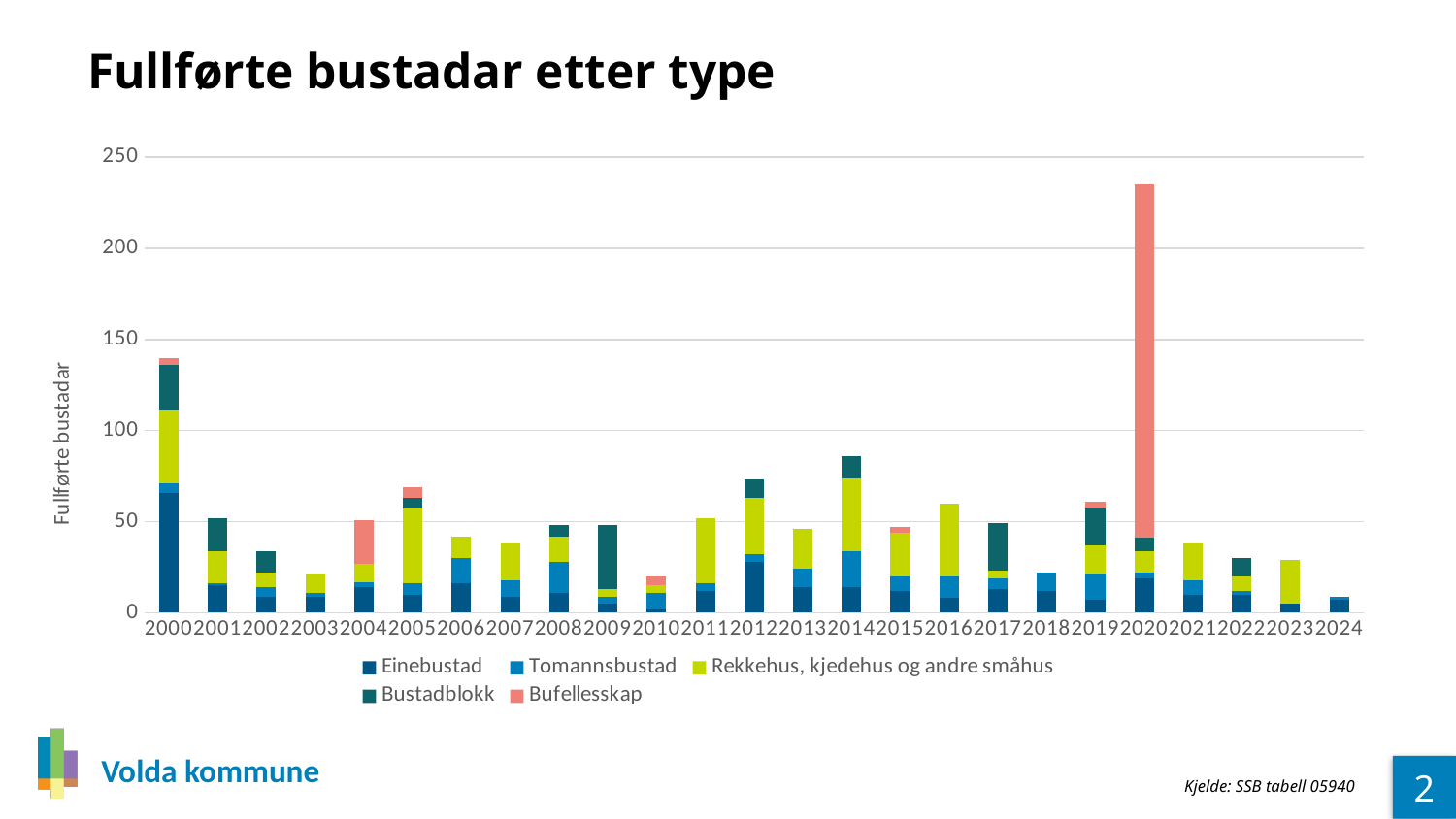
Which year has the lowest total of completed dwellings? 2024 Is the total for 2020 greater or less than 200? greater Is the total for 2014 greater or less than 50? greater Which year has a larger total, 2000 or 2001? 2000 What kind of chart is shown on the slide? Stacked bar chart How many years are shown along the x axis? 25 Is the total for 2024 greater or less than 50? less Which series is shown in the salmon/pink colour in the legend? Bufellesskap Which year has the highest total of completed dwellings? 2020 How many series does the legend list? 5 What is the title of the chart? Fullførte bustadar etter type